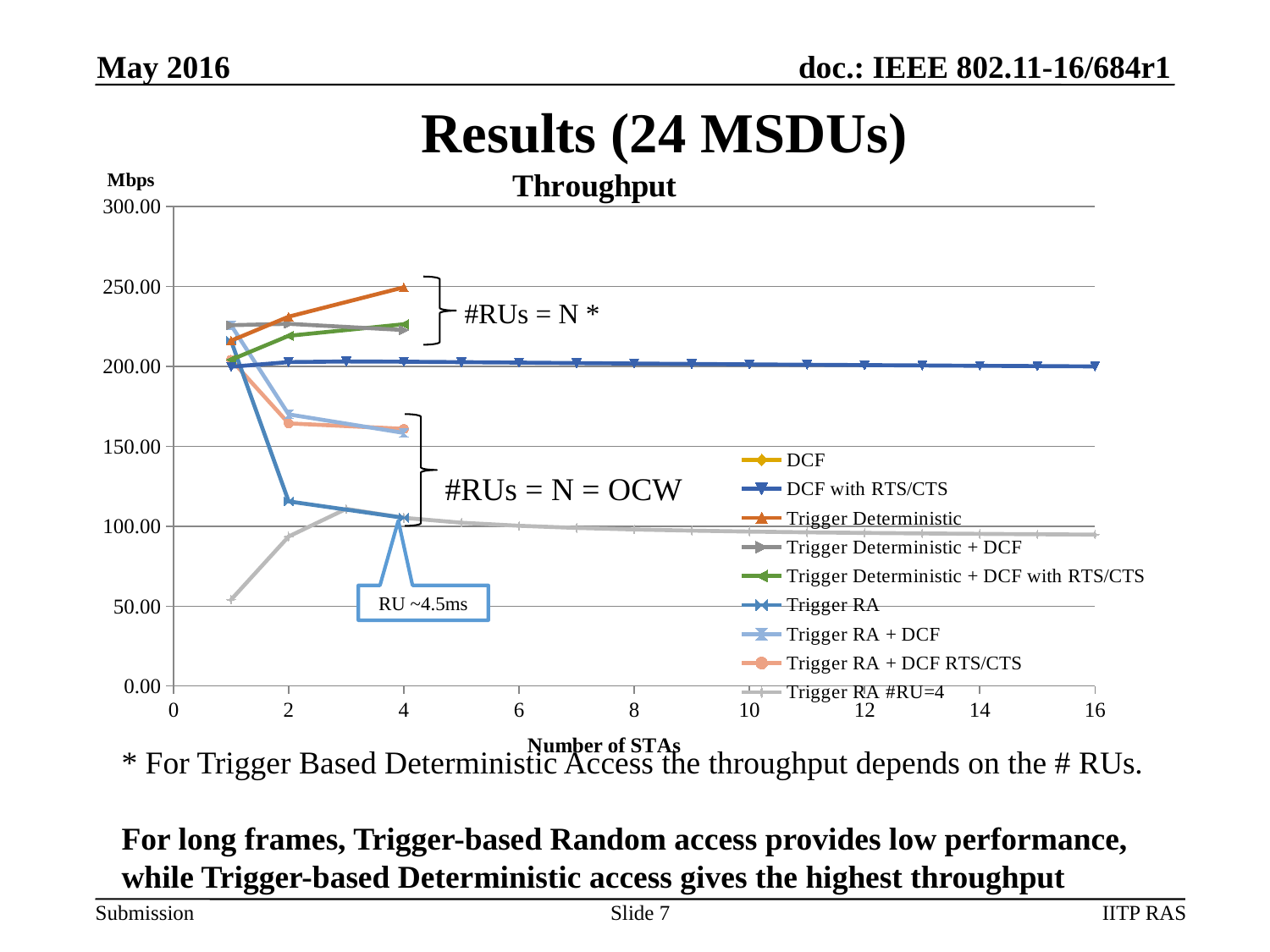
At 2 STAs, which series has the larger value: DCF with RTS/CTS or Trigger RA? DCF with RTS/CTS Is the value for Trigger RA at 4 STAs greater or less than 150? less What is the title of the chart? Throughput Is the value for Trigger RA #RU=4 at 1 STA greater or less than 100? less Does the Trigger Deterministic series rise or fall as the number of STAs increases from 1 to 4? rise What kind of chart is shown on the slide? line chart How many series does the legend of the Throughput chart list? 9 Does the Trigger RA series rise or fall as the number of STAs increases from 1 to 4? fall Is the value for Trigger Deterministic at 4 STAs greater or less than 200? greater What unit is shown on the y axis of the chart? Mbps At 4 STAs, which series has the larger value: Trigger Deterministic or Trigger RA? Trigger Deterministic